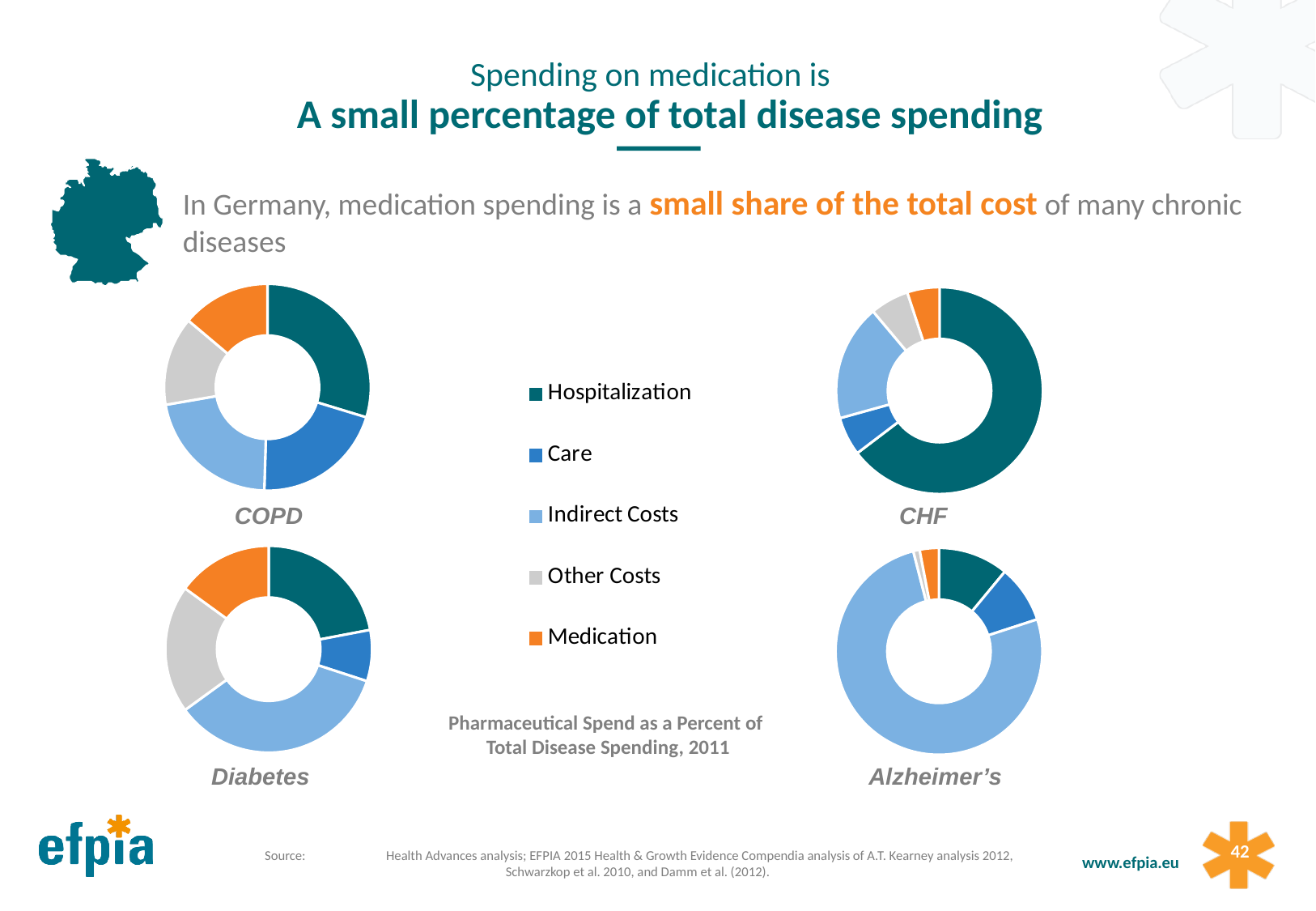
In the Diabetes chart, which is larger: Other Costs or Medication? Other Costs In the CHF chart, which category has the largest share? Hospitalization In the Alzheimer's chart, which category has the smallest share? Other Costs In the Alzheimer's chart, which category has the largest share? Indirect Costs In the Diabetes chart, which category has the smallest share? Care How many charts are shown on the slide? 4 In the CHF chart, which is larger: Hospitalization or Indirect Costs? Hospitalization In the COPD chart, which category has the largest share? Hospitalization What kind of chart is used for COPD on this slide? Pie chart (donut) How many categories does the legend list? 5 Which colour represents Medication in the charts? Orange